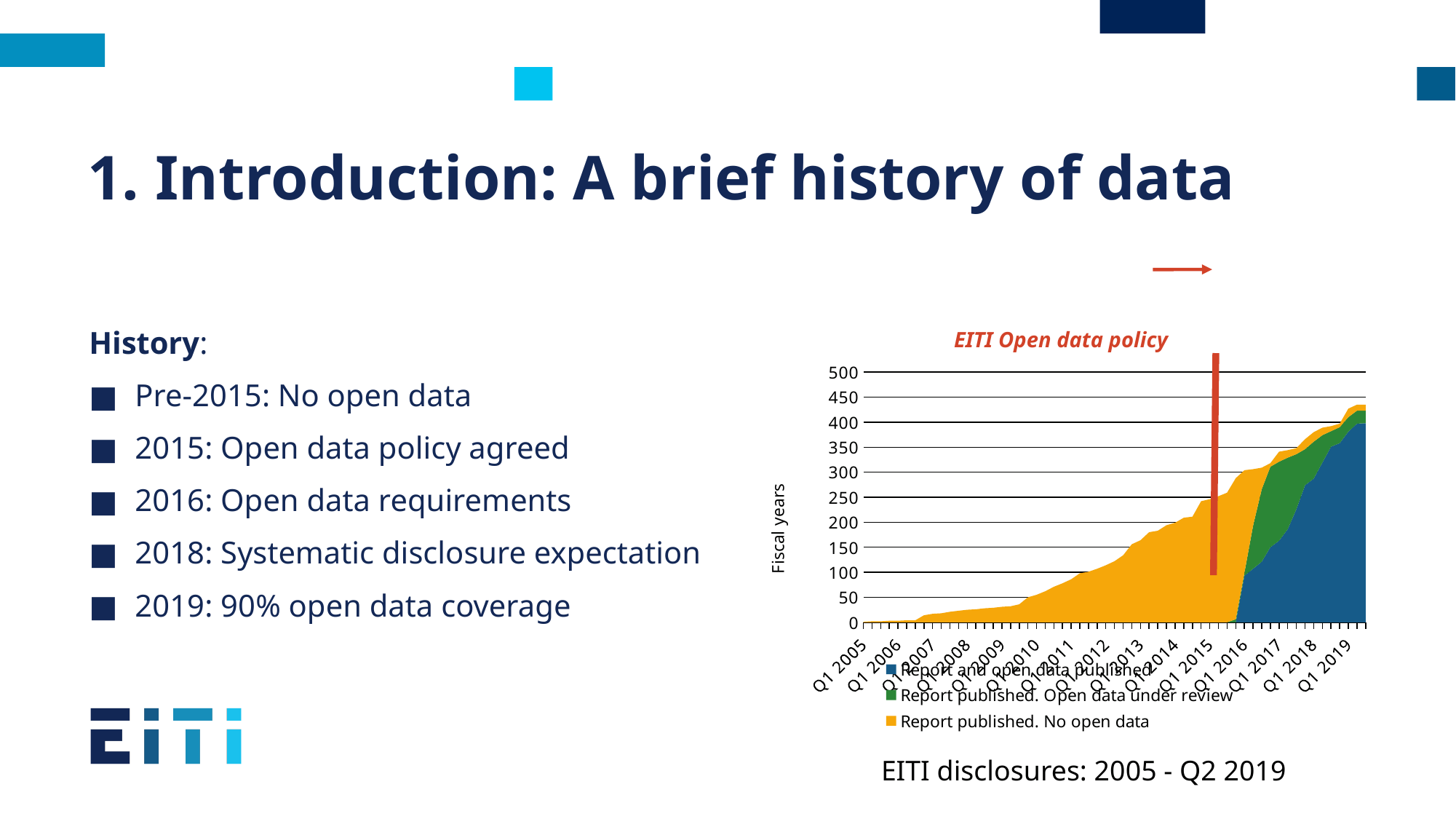
How many series does the chart's legend list? 3 Which series accounts for the largest share of the total at Q1 2019? Report and open data published Is the total value at Q1 2019 greater or less than 400? greater Is the total value at Q1 2018 greater or less than 350? greater What is the label on the chart's vertical axis? Fiscal years Does the total number of fiscal years disclosed rise or fall from Q1 2005 to Q1 2019? Rise Is the total value at Q1 2012 greater or less than 100? greater How many year labels are shown along the x axis? 15 What kind of chart is shown on the slide? Stacked area chart